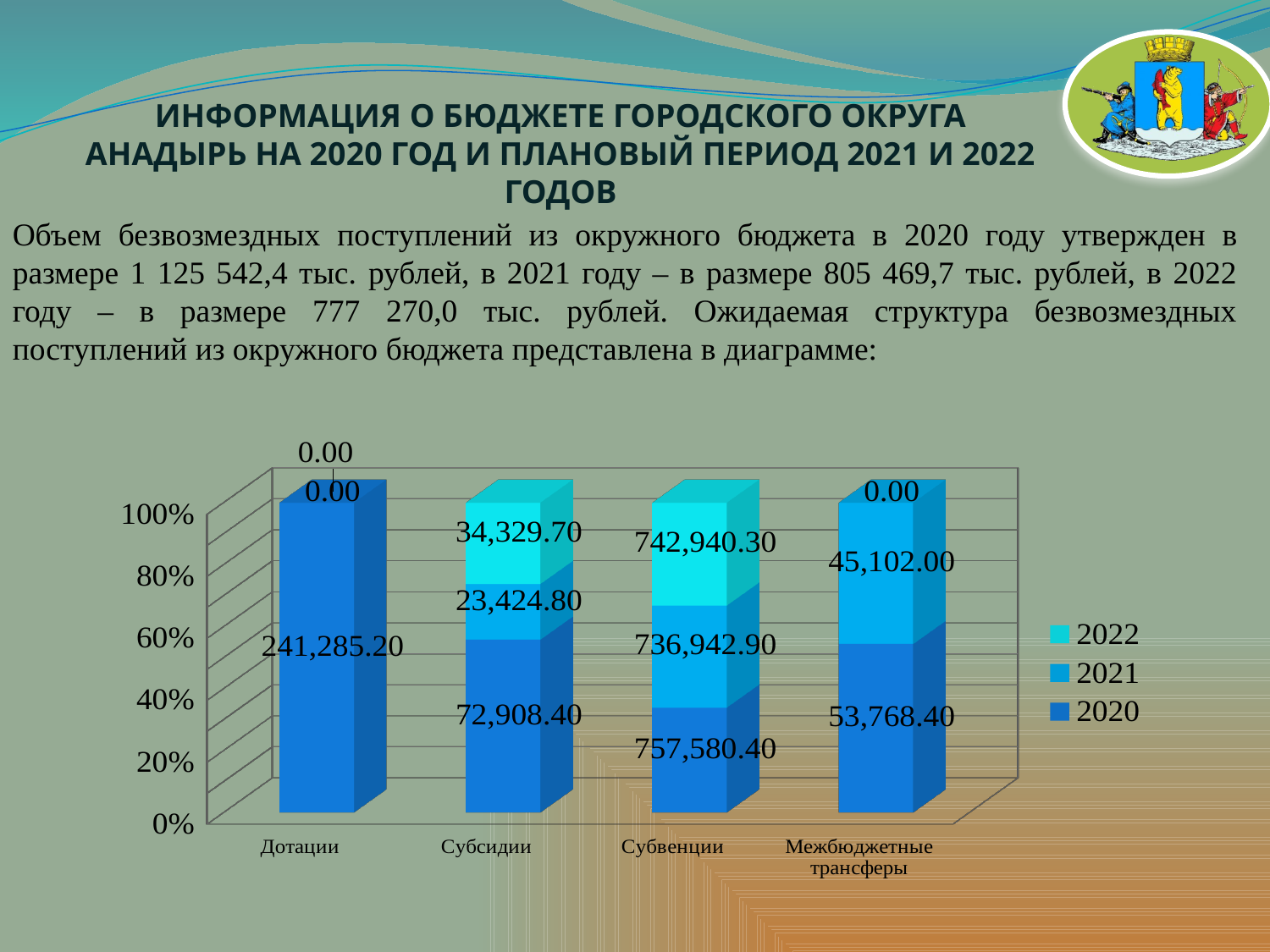
Which category has the lowest value in the 2020 series? Межбюджетные трансферы What is the value for Дотации in the 2020 series? 241,285.20 For Субсидии, which is larger: the 2021 value or the 2022 value? 2022 What is the value for Межбюджетные трансферы in the 2021 series? 45,102.00 What is the value for Субвенции in the 2022 series? 742,940.30 What is the total of the three series for Межбюджетные трансферы? 98,870.40 What is the difference between the 2020 and 2021 values for Субвенции? 20,637.50 What is the value for Субсидии in the 2021 series? 23,424.80 Which category has the highest value in the 2020 series? Субвенции How many categories are shown on the x axis? 4 How many series does the legend list? 3 What type of chart is shown on the slide? stacked bar chart